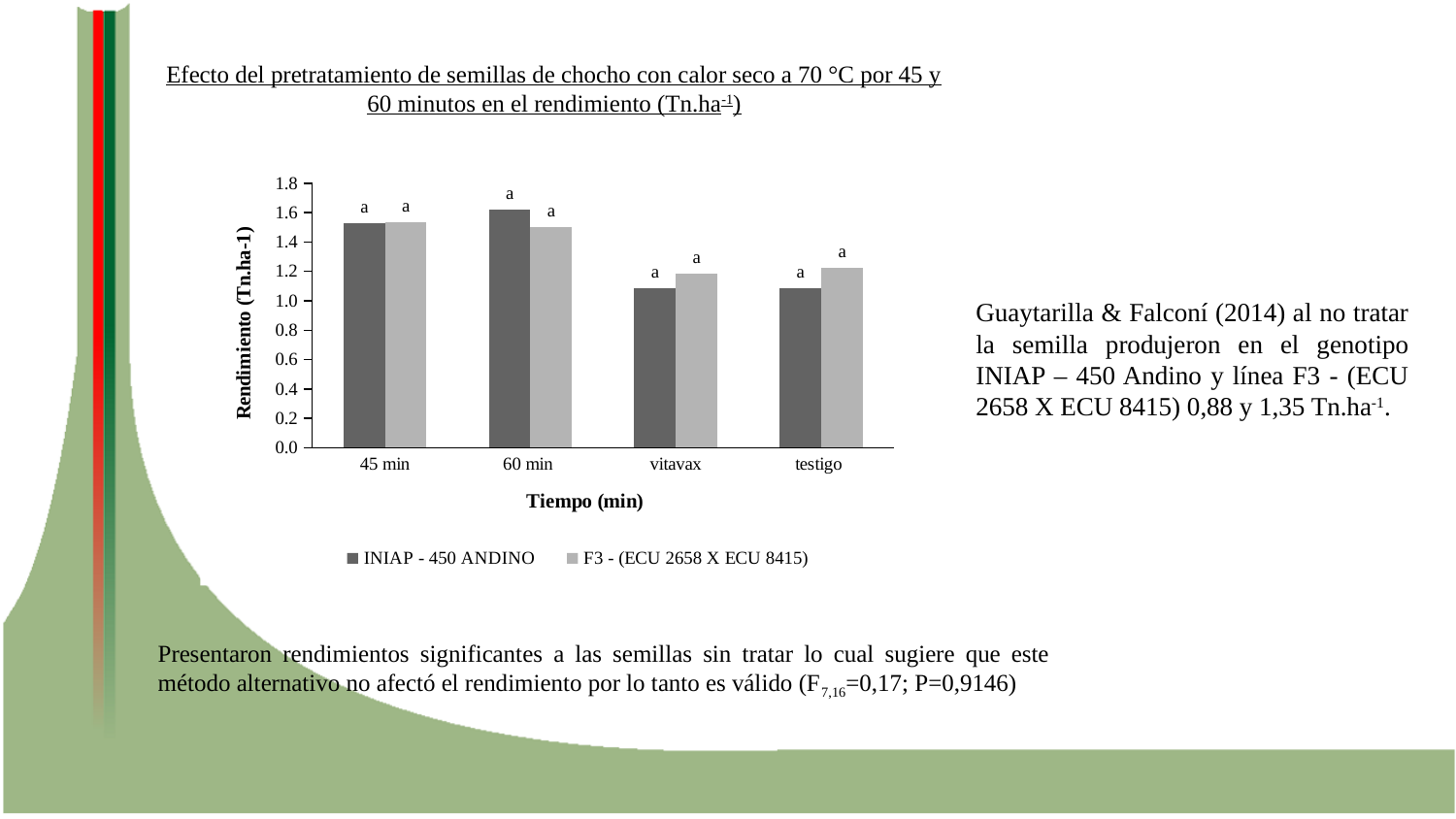
Is the value for F3 - (ECU 2658 X ECU 8415) at vitavax greater or less than 1.4? less How many series does the chart legend list? 2 How many categories are shown on the x axis of the chart? 4 What is the title of the vertical axis of the chart? Rendimiento (Tn.ha-1) Which category has the highest bar for the INIAP - 450 ANDINO series? 60 min What kind of chart is shown on the slide? Bar chart For vitavax, which series has the larger value, INIAP - 450 ANDINO or F3 - (ECU 2658 X ECU 8415)? F3 - (ECU 2658 X ECU 8415) Is the value for INIAP - 450 ANDINO at 60 min greater or less than 1.4? greater What is the title of the horizontal axis of the chart? Tiempo (min) Is the value for INIAP - 450 ANDINO at testigo greater or less than 0.8? greater For testigo, which series has the larger value, INIAP - 450 ANDINO or F3 - (ECU 2658 X ECU 8415)? F3 - (ECU 2658 X ECU 8415) At 60 min, which series has the larger value, INIAP - 450 ANDINO or F3 - (ECU 2658 X ECU 8415)? INIAP - 450 ANDINO